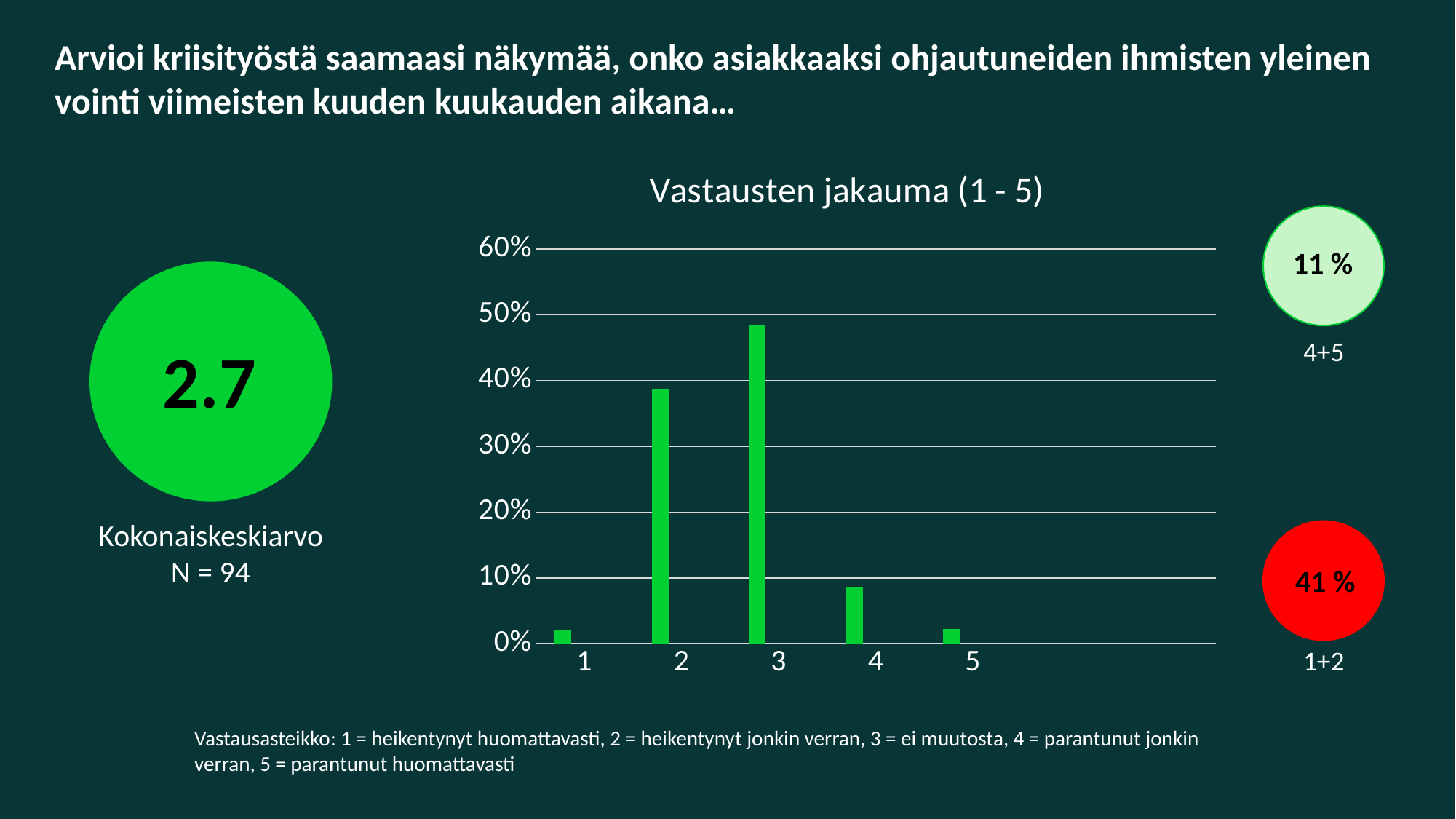
Is the value for category 3 greater or less than 40%? greater Is the value for category 2 greater or less than 30%? greater Which is larger, the value for category 2 or the value for category 3? 3 Which category has the highest bar in the chart? 3 What type of chart is shown on the slide? bar chart Is the value for category 5 greater or less than 10%? less How many categories are shown on the x axis of the chart? 5 What percentage is shown in the red circle for responses 1+2? 41 % What is the title of the chart? Vastausten jakauma (1 - 5) Which is larger, the value for category 4 or the value for category 5? 4